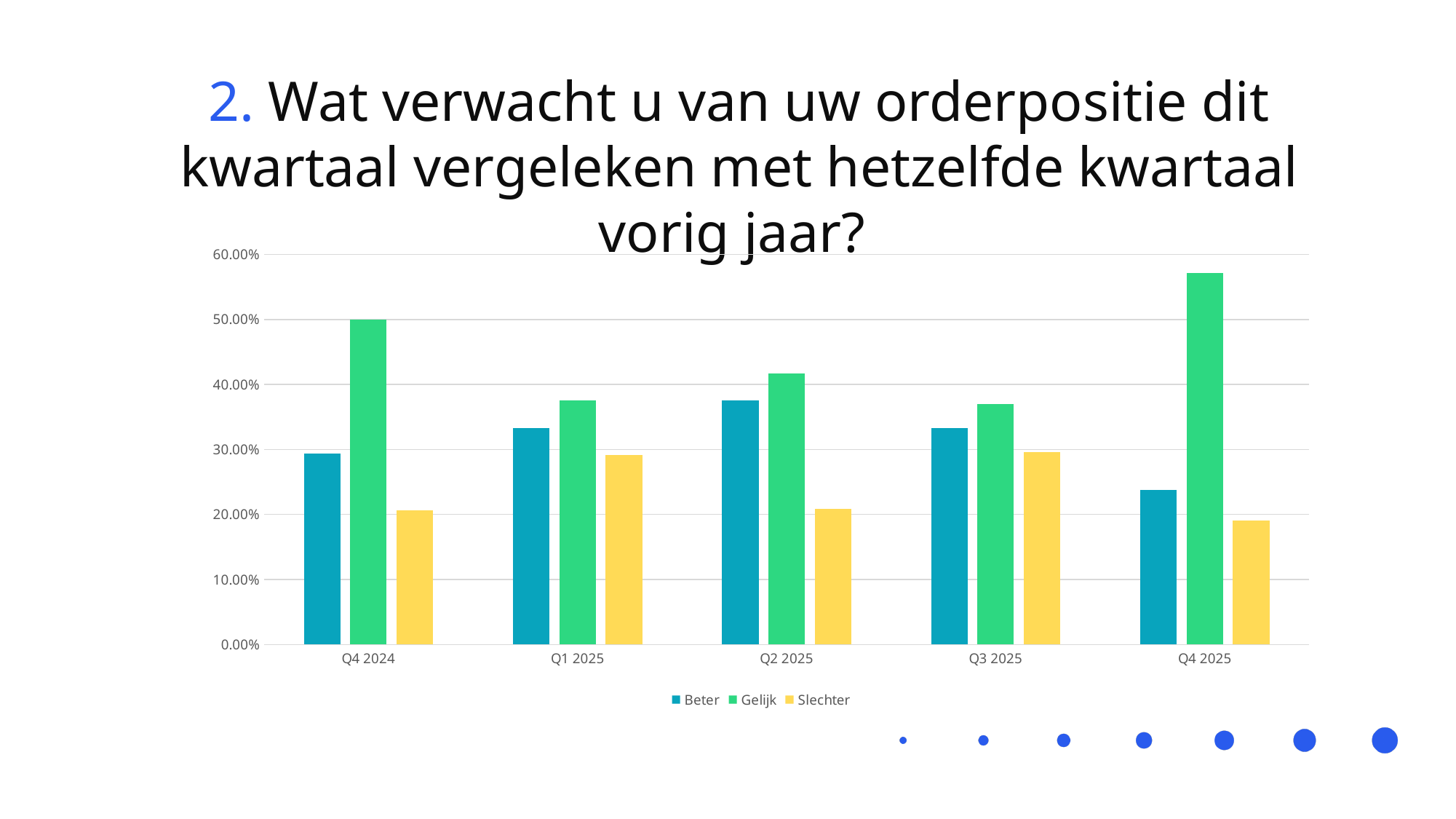
In Q3 2025, which is larger: Beter or Gelijk? Gelijk Which colour represents the Slechter series in the legend? yellow In which quarter is the Beter bar the highest? Q2 2025 Is the value for Gelijk in Q3 2025 greater or less than 40.00%? less What kind of chart is shown on the slide? bar chart In which quarter is the Gelijk bar the highest? Q4 2025 Is the value for Beter in Q1 2025 greater or less than 30.00%? greater How many series does the legend list? 3 In which quarter is the Beter bar the lowest? Q4 2025 How many quarters are shown on the x axis of the chart? 5 Which series has the tallest bar in Q4 2025? Gelijk Is the value for Gelijk in Q4 2025 greater or less than 50.00%? greater